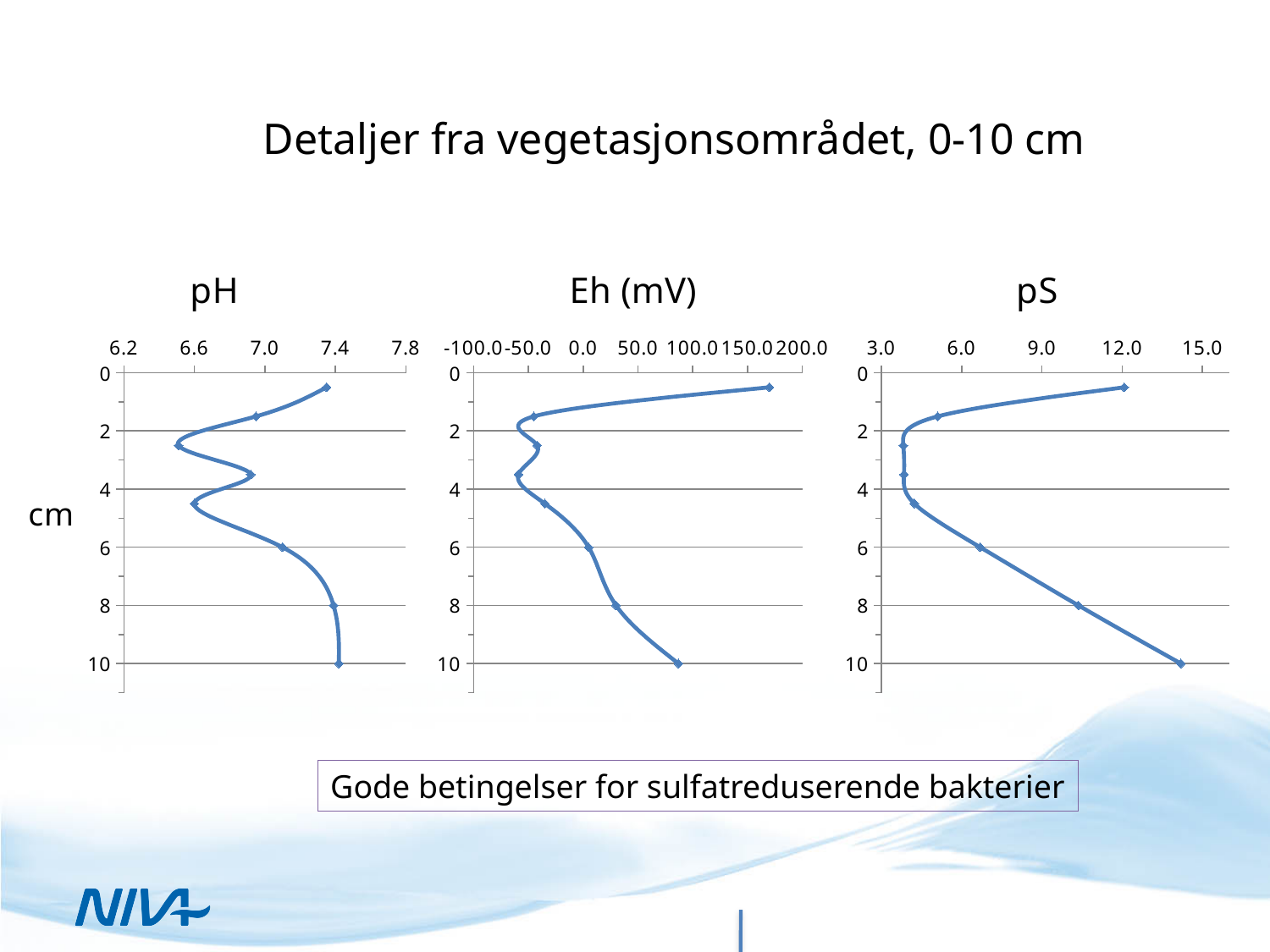
In the Eh (mV) chart, is the value at about 1.5 cm depth greater or less than 0.0? less In the Eh (mV) chart, is the value at 0 to 1 cm depth greater or less than 150.0? greater How many data points are plotted in the Eh (mV) chart? 8 In the Eh (mV) chart, is the value at 10 cm depth greater or less than 50.0? greater What kind of chart is the pH chart? line chart What is the title of the middle chart? Eh (mV) In the pS chart, which is larger: the value at 10 cm depth or the value at 6 cm depth? 10 cm In the Eh (mV) chart, at which depth is the highest value plotted? the shallowest point, near 0 cm In the pS chart, does the value increase or decrease with depth from 4 cm down to 10 cm? increase What unit is shown as the label of the vertical axis shared by the three charts? cm